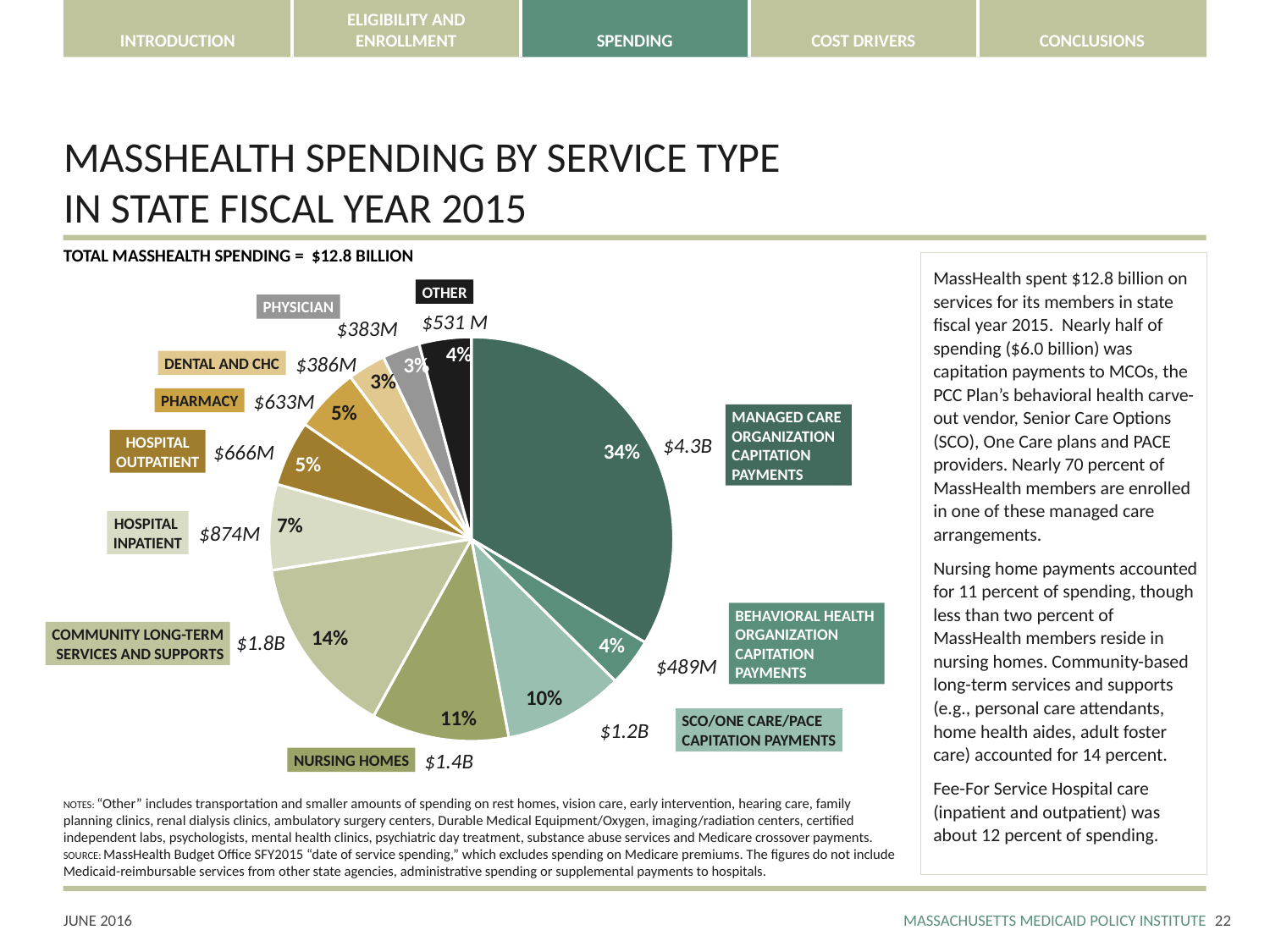
Which had a larger share of spending: Community Long-Term Services and Supports or Nursing Homes? Community Long-Term Services and Supports What was the dollar amount of spending on Hospital Inpatient services? $874M How many service-type slices does the pie chart have? 11 What share of MassHealth spending went to Managed Care Organization Capitation Payments? 34% What is the difference in dollars between Hospital Inpatient ($874M) and Hospital Outpatient ($666M) spending? $208M What is the total MassHealth spending shown for the pie chart? $12.8 billion What was the dollar amount of spending on Behavioral Health Organization Capitation Payments? $489M What was the dollar amount of spending on Nursing Homes? $1.4B Which service type had the smallest dollar amount of spending? Physician ($383M) Which service type accounted for the largest share of MassHealth spending? Managed Care Organization Capitation Payments What type of chart is shown on the slide? Pie chart What percentage of spending went to Community Long-Term Services and Supports? 14%